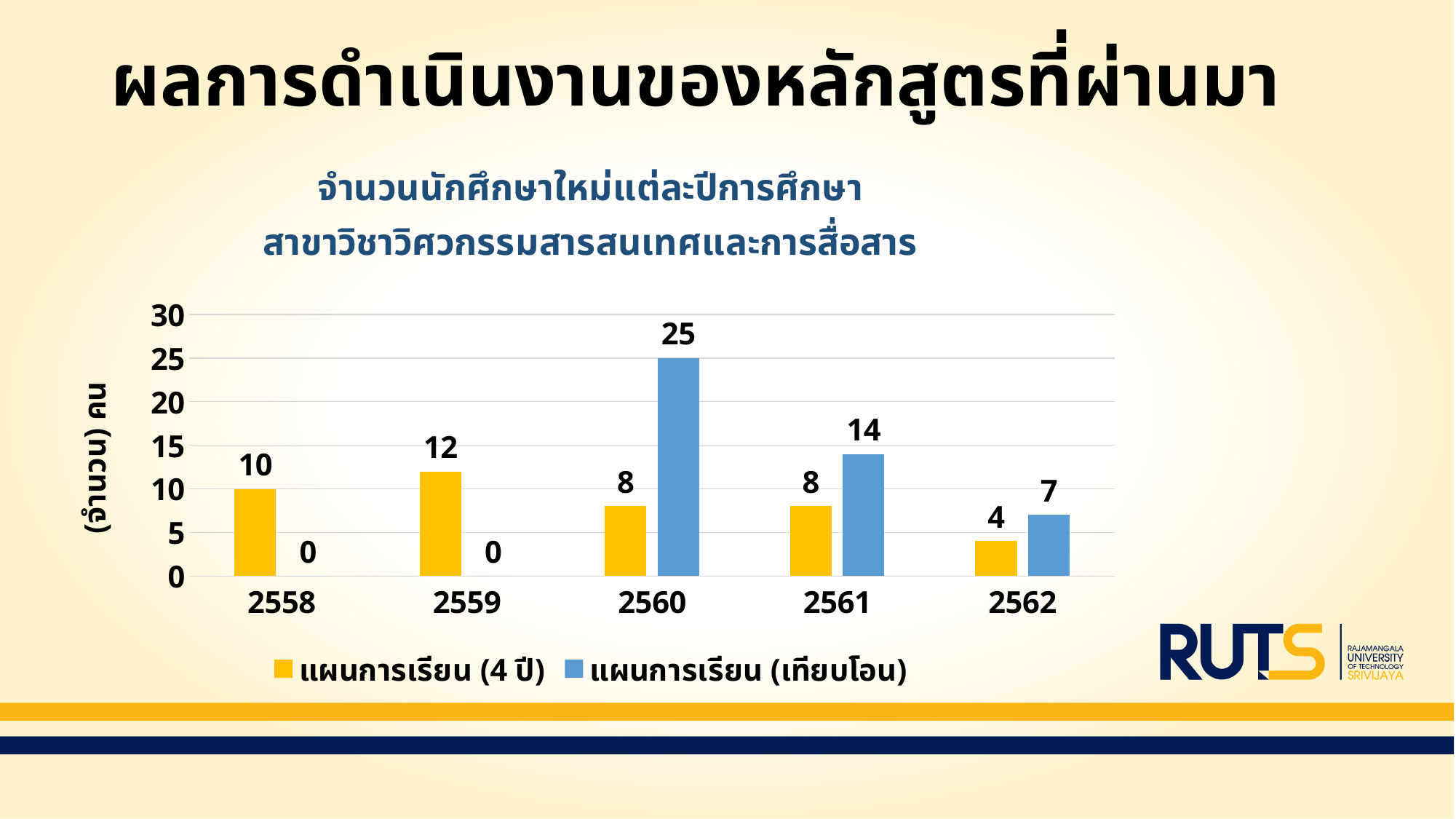
What colour are the bars for แผนการเรียน (เทียบโอน)? blue Which year has the lowest value for แผนการเรียน (4 ปี)? 2562 How many years are shown on the x axis? 5 What is the difference between แผนการเรียน (เทียบโอน) and แผนการเรียน (4 ปี) in 2561? 6 In 2562, which series has the larger value, แผนการเรียน (4 ปี) or แผนการเรียน (เทียบโอน)? แผนการเรียน (เทียบโอน) What is the value for แผนการเรียน (เทียบโอน) in 2562? 7 Which year has the highest value for แผนการเรียน (เทียบโอน)? 2560 How many series does the legend list? 2 What is the value for แผนการเรียน (เทียบโอน) in 2560? 25 Does the value for แผนการเรียน (4 ปี) rise or fall from 2559 to 2562? fall What is the value for แผนการเรียน (4 ปี) in 2559? 12 What kind of chart is shown on the slide? bar chart